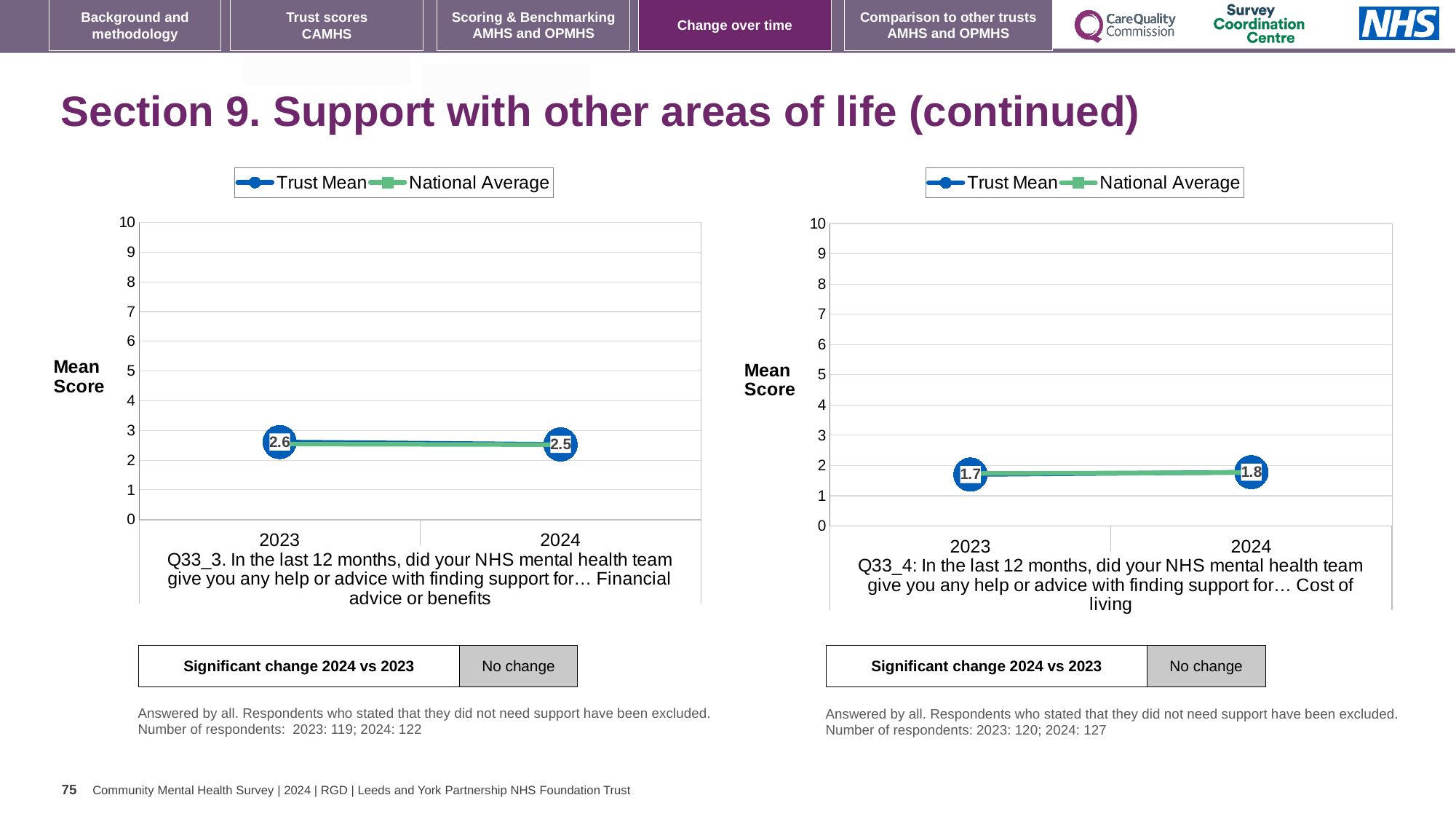
On the right chart (Q33_4, Cost of living), what is the Trust Mean for 2024? 1.8 How many series does the legend of the left chart (Q33_3) list? 2 How many years are plotted on the x axis of the right chart (Q33_4, Cost of living)? 2 On the left chart (Q33_3, Financial advice or benefits), what is the Trust Mean for 2024? 2.5 What kind of chart is the left chart (Q33_3, Financial advice or benefits)? line chart On the left chart (Q33_3, Financial advice or benefits), what is the Trust Mean for 2023? 2.6 On the right chart (Q33_4, Cost of living), what is the Trust Mean for 2023? 1.7 On the right chart (Q33_4, Cost of living), which year has the higher Trust Mean, 2023 or 2024? 2024 On the right chart (Q33_4, Cost of living), is the National Average for 2024 greater or less than 5? less On the left chart (Q33_3, Financial advice or benefits), what is the difference between the Trust Mean for 2023 and 2024? 0.1 On the right chart (Q33_4, Cost of living), does the Trust Mean rise or fall from 2023 to 2024? rise On the left chart (Q33_3, Financial advice or benefits), does the Trust Mean rise or fall from 2023 to 2024? fall